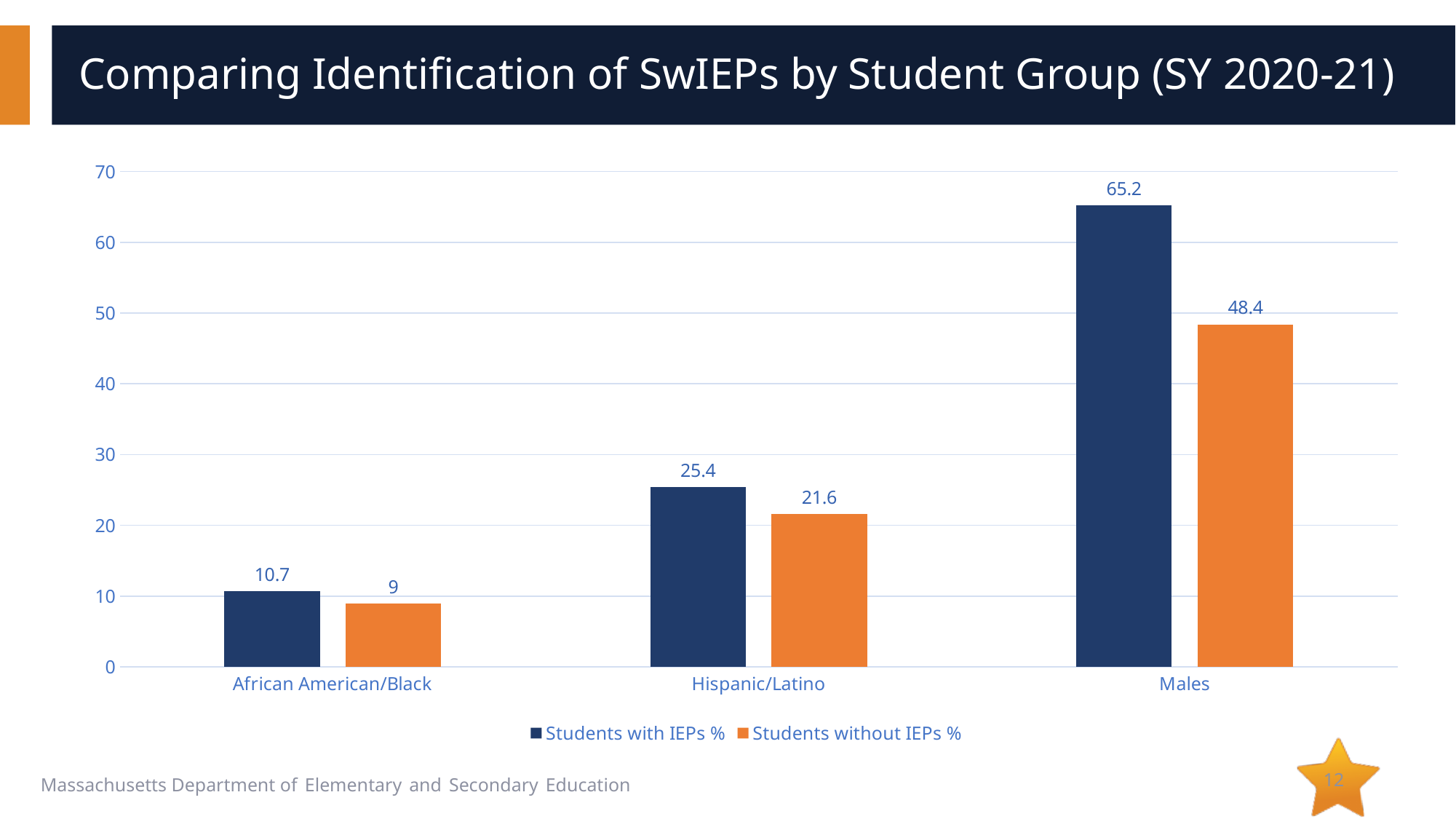
What is the difference between Students with IEPs % and Students without IEPs % for Hispanic/Latino? 3.8 What kind of chart is shown on the slide? Bar chart What is the value for Students with IEPs % for Hispanic/Latino? 25.4 Which is larger for African American/Black: Students with IEPs % or Students without IEPs %? Students with IEPs % What is the value for Students without IEPs % for African American/Black? 9 Which category has the highest value for Students without IEPs %? Males What is the value for Students with IEPs % for Males? 65.2 What is the difference between Students with IEPs % and Students without IEPs % for Males? 16.8 How many categories are shown on the x axis? 3 What is the title of the chart? Comparing Identification of SwIEPs by Student Group (SY 2020-21) Which category has the lowest value for Students with IEPs %? African American/Black How many series does the legend list? 2